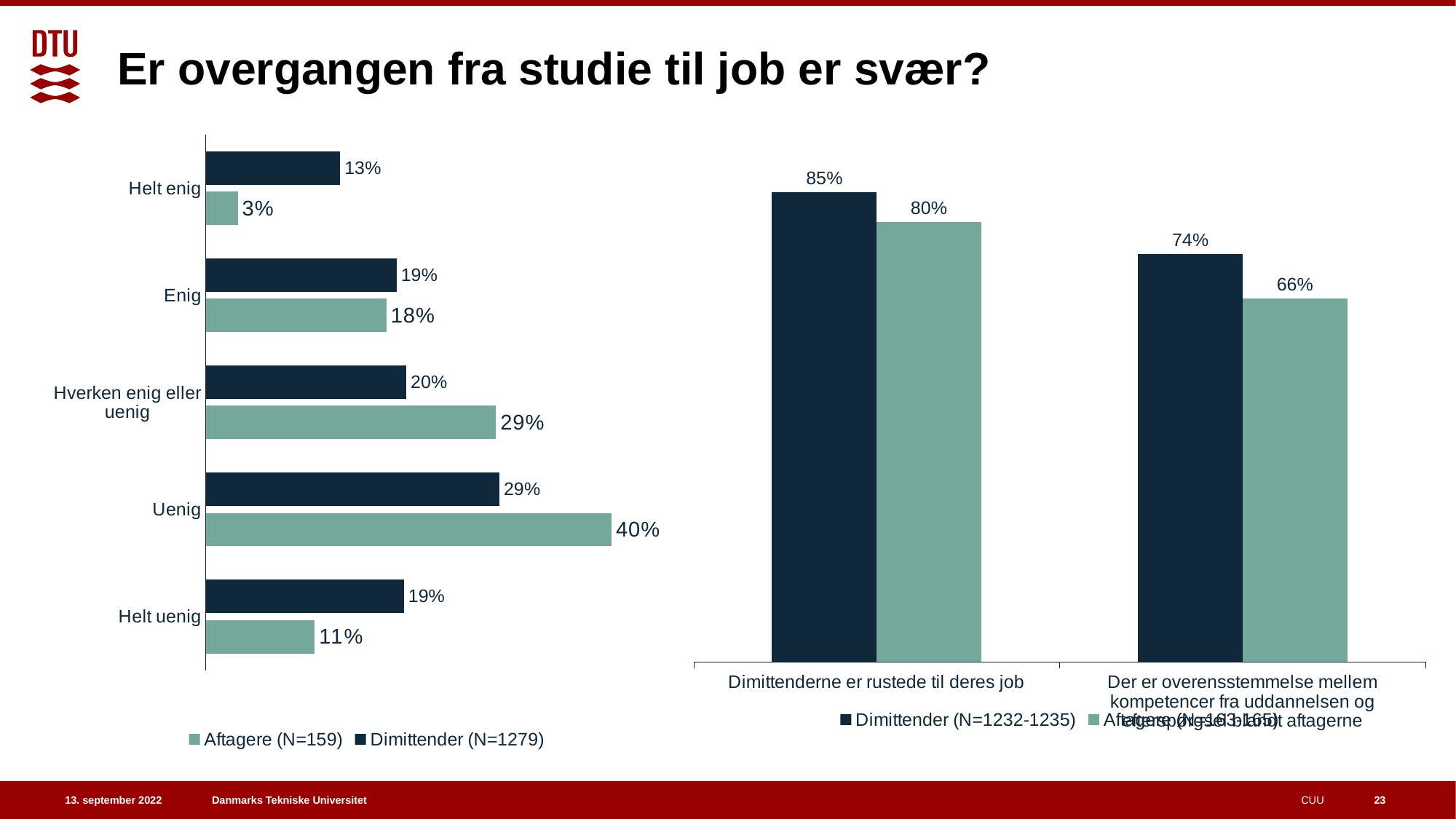
In the left chart, which category has the highest value for Dimittender (N=1279)? Uenig How many series does the legend of the right chart list? 2 In the left chart, what is the value for Dimittender (N=1279) for Helt enig? 13% In the right chart, what is the difference between the Dimittender and Aftagere values for 'Dimittenderne er rustede til deres job'? 5% In the left chart, what is the value for Aftagere (N=159) for Uenig? 40% What kind of chart is the left chart? Bar chart In the left chart, for Helt uenig, which series has the larger value, Aftagere (N=159) or Dimittender (N=1279)? Dimittender (N=1279) In the right chart, what is the value for Aftagere in the right-hand category? 66% In the right chart, what is the value for Dimittender for 'Dimittenderne er rustede til deres job'? 85% How many categories are shown in the left chart? 5 In the left chart, what is the difference between the Aftagere and Dimittender values for Hverken enig eller uenig? 9% In the left chart, which category has the lowest value for Aftagere (N=159)? Helt enig